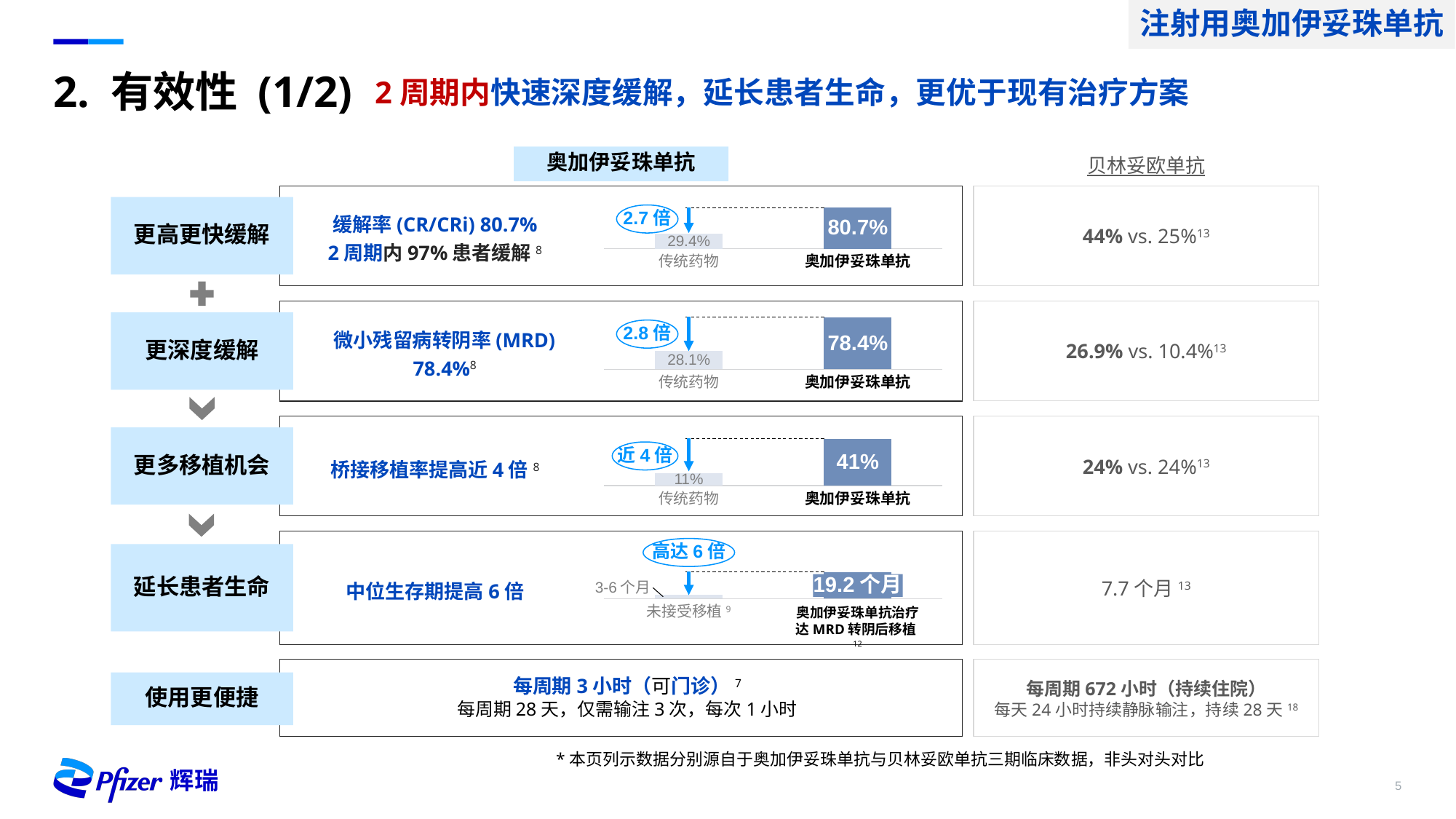
In the bar chart in the 延长患者生命 row, what is the value labelled for 奥加伊妥珠单抗治疗达 MRD 转阴后移植? 19.2 个月 In the bar chart in the 更多移植机会 row, what is the value for 传统药物? 11% In the bar chart in the 更深度缓解 row, what is the value for 传统药物? 28.1% What kind of chart is shown in the 更深度缓解 row? Bar chart In the bar chart in the 更多移植机会 row, what is the difference between the 奥加伊妥珠单抗 value and the 传统药物 value? 30% In the bar chart in the 更高更快缓解 row, which bar is higher, 传统药物 or 奥加伊妥珠单抗? 奥加伊妥珠单抗 In the bar chart in the 更深度缓解 row, what is the difference between the 奥加伊妥珠单抗 value and the 传统药物 value? 50.3% In the bar chart in the 更深度缓解 row, what is the value for 奥加伊妥珠单抗? 78.4% How many bars are shown in the bar chart in the 更多移植机会 row? 2 In the bar chart in the 更高更快缓解 row, what is the value for 奥加伊妥珠单抗? 80.7% In the bar chart in the 更高更快缓解 row, what is the value for 传统药物? 29.4% In the bar chart in the 更多移植机会 row, what is the value for 奥加伊妥珠单抗? 41%